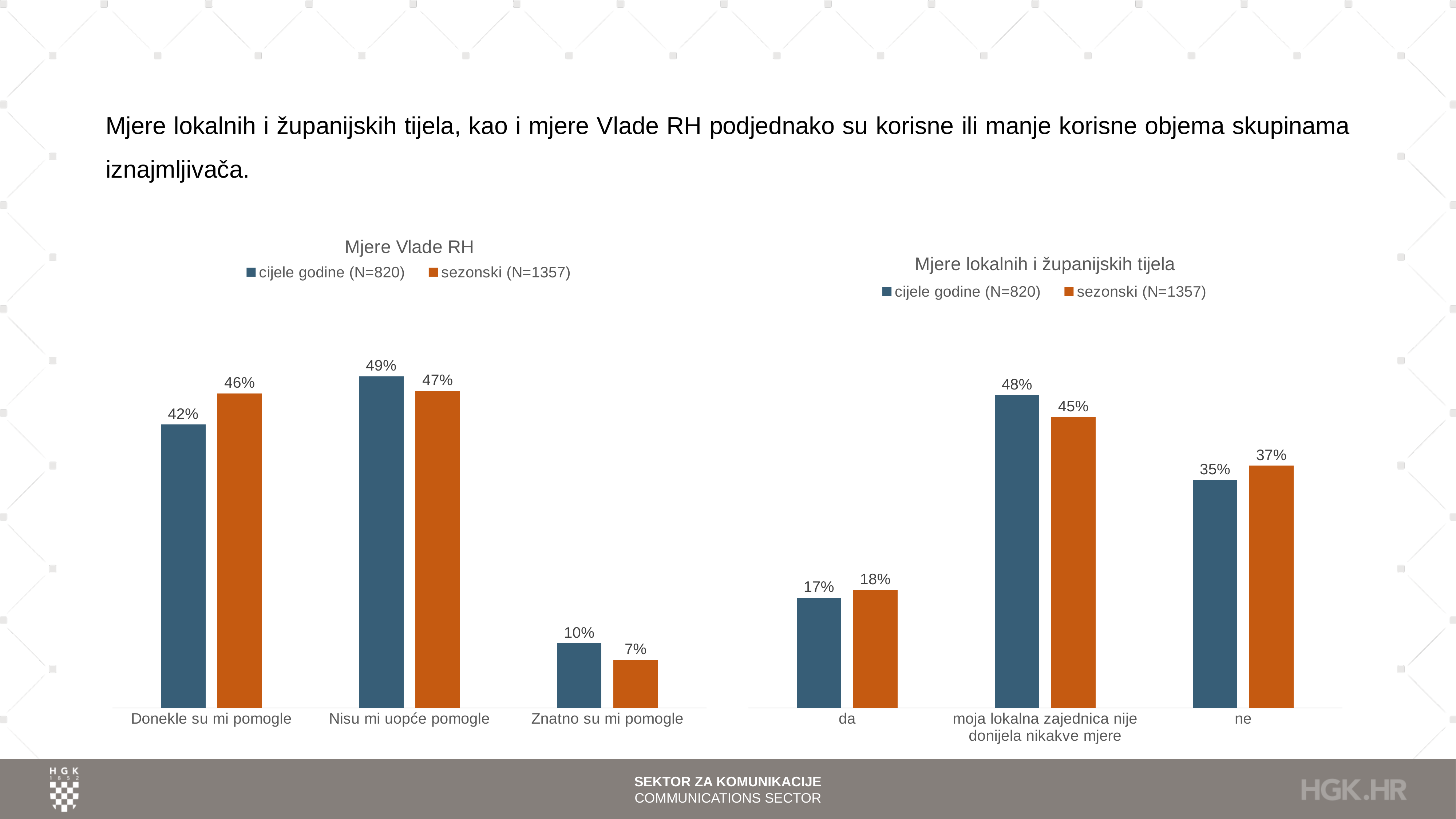
In the 'Mjere lokalnih i županijskih tijela' chart, what is the difference between 'cijele godine (N=820)' and 'sezonski (N=1357)' for 'moja lokalna zajednica nije donijela nikakve mjere'? 3% In the 'Mjere lokalnih i županijskih tijela' chart, what is the value for 'cijele godine (N=820)' in the 'da' category? 17% In the 'Mjere Vlade RH' chart, what is the value for 'cijele godine (N=820)' in the 'Nisu mi uopće pomogle' category? 49% How many series does the legend of the 'Mjere Vlade RH' chart list? 2 What type of chart is the 'Mjere lokalnih i županijskih tijela' chart? Bar chart In the 'Mjere Vlade RH' chart, which category has the highest value for 'cijele godine (N=820)'? Nisu mi uopće pomogle In the 'Mjere lokalnih i županijskih tijela' chart, which category has the lowest value for 'sezonski (N=1357)'? da How many categories are shown in the 'Mjere lokalnih i županijskih tijela' chart? 3 In the 'Mjere Vlade RH' chart, what is the value for 'sezonski (N=1357)' in the 'Znatno su mi pomogle' category? 7% In the 'Mjere Vlade RH' chart, what is the difference between the 'sezonski (N=1357)' and 'cijele godine (N=820)' values for 'Donekle su mi pomogle'? 4% In the 'Mjere lokalnih i županijskih tijela' chart, what is the value for 'sezonski (N=1357)' in the 'ne' category? 37% In the 'Mjere Vlade RH' chart, which series has the larger value for 'Znatno su mi pomogle'? cijele godine (N=820)